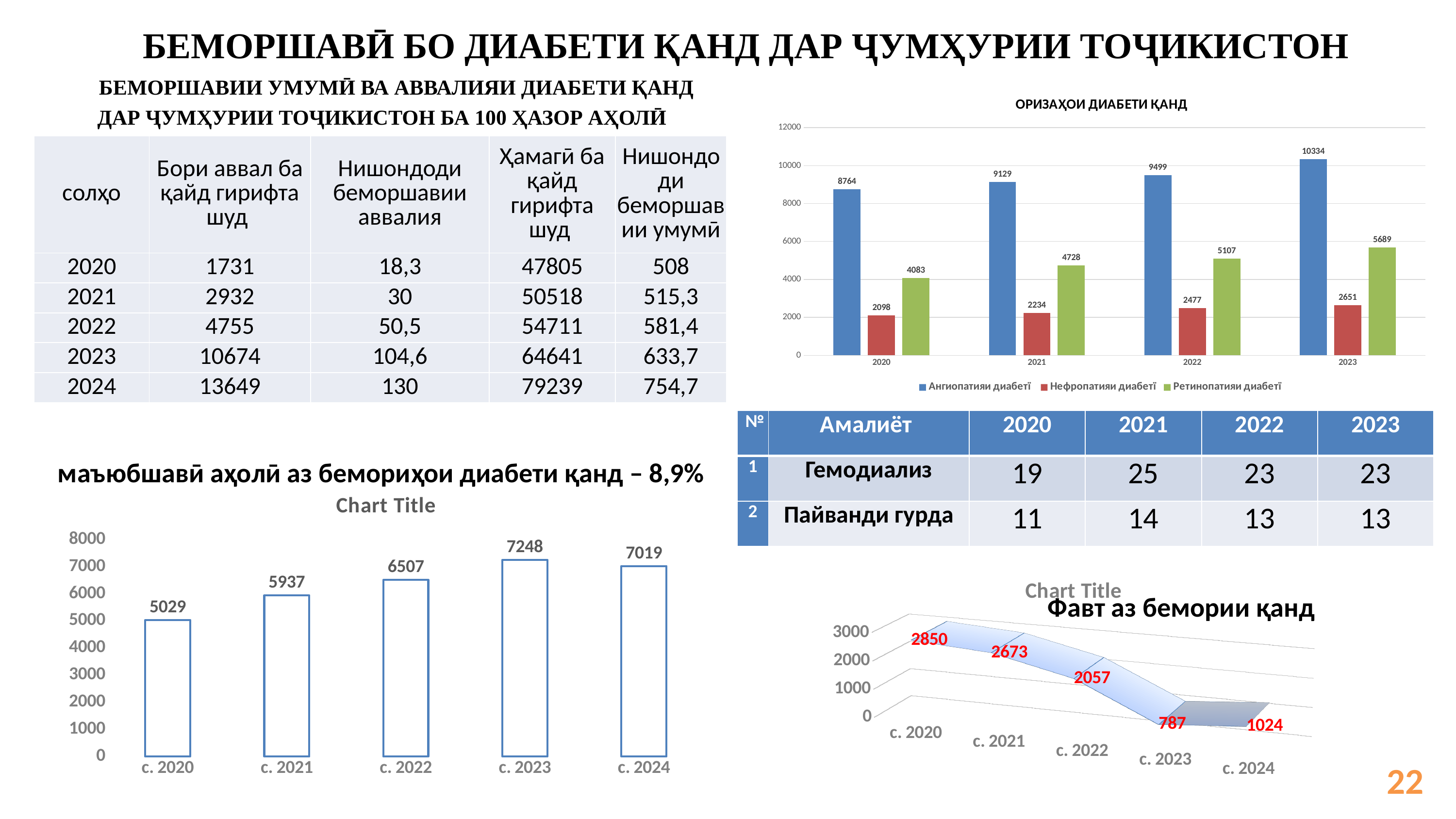
In the bottom-right chart labelled Фавт аз бемории қанд, what is the value for с. 2021? 2673 In the bottom-right chart labelled Фавт аз бемории қанд, which year has the lowest value? с. 2023 In the bottom-left bar chart, what is the value for с. 2022? 6507 In the bottom-left bar chart, what is the difference between the values for с. 2023 and с. 2024? 229 In the top-right chart titled ОРИЗАҲОИ ДИАБЕТИ ҚАНД, how many series does the legend list? 3 In the top-right chart titled ОРИЗАҲОИ ДИАБЕТИ ҚАНД, does the Ангиопатияи диабетӣ series rise or fall from 2020 to 2023? rise In the top-right chart titled ОРИЗАҲОИ ДИАБЕТИ ҚАНД, what is the value of Нефропатияи диабетӣ for 2020? 2098 In the top-right chart titled ОРИЗАҲОИ ДИАБЕТИ ҚАНД, which series has the lowest value in every year? Нефропатияи диабетӣ In the bottom-left bar chart, which year has the highest value? с. 2023 In the top-right chart titled ОРИЗАҲОИ ДИАБЕТИ ҚАНД, what is the value of Ангиопатияи диабетӣ for 2023? 10334 In the top-right chart titled ОРИЗАҲОИ ДИАБЕТИ ҚАНД, what is the difference between Ретинопатияи диабетӣ in 2023 and in 2022? 582 In the bottom-left bar chart, how many bars are there? 5